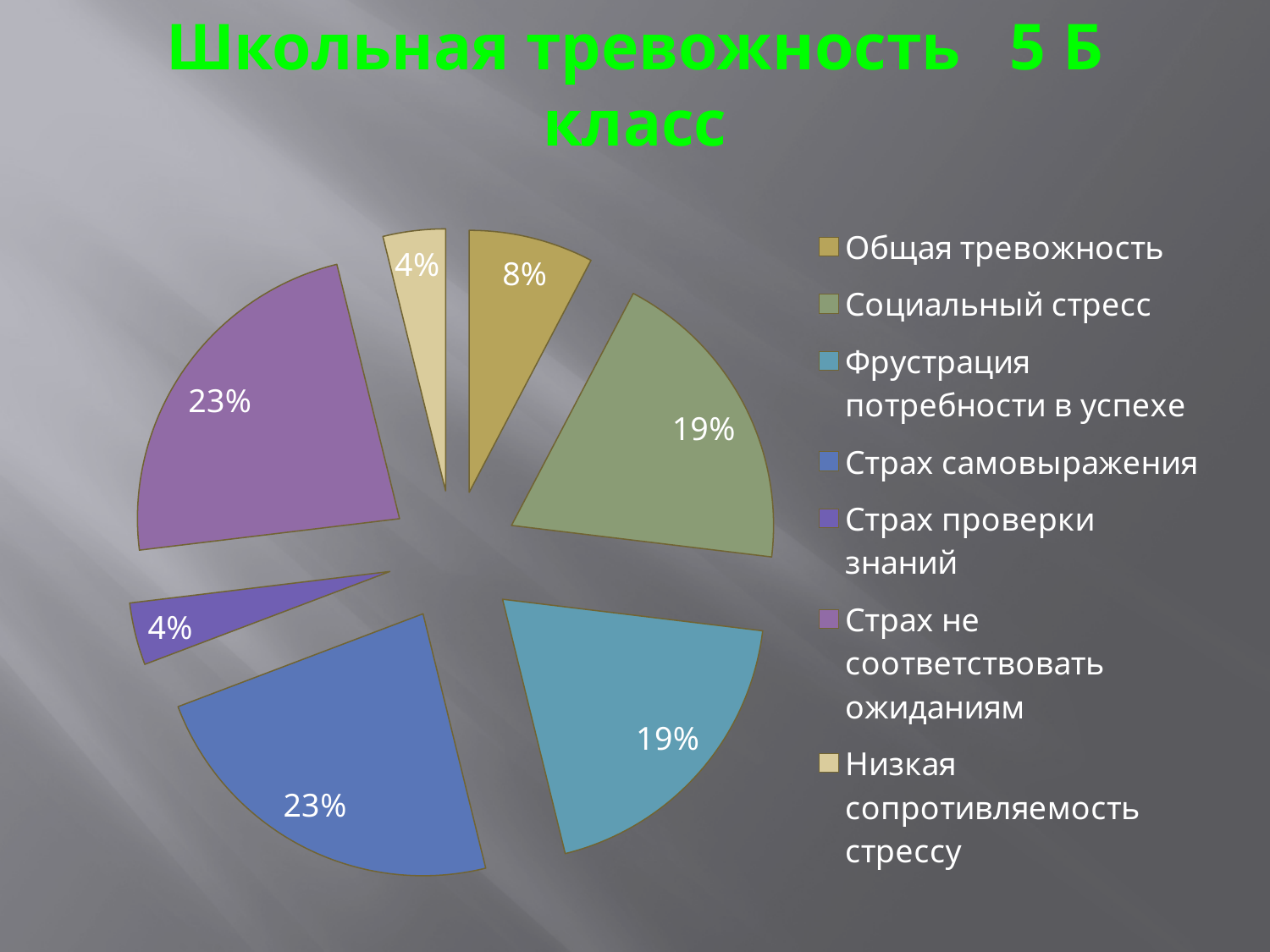
How many entries does the legend list? 7 How many slices does the pie chart have? 7 Which is larger, Общая тревожность or Социальный стресс? Социальный стресс What is the share for Страх самовыражения? 23% What is the share for Низкая сопротивляемость стрессу? 4% What is the difference between the shares for Страх самовыражения and Общая тревожность? 15% What is the share for Фрустрация потребности в успехе? 19% What is the share for Социальный стресс? 19% What is the title of the chart on the slide? Школьная тревожность 5 Б класс What type of chart is shown on the slide? pie chart What is the share for Общая тревожность? 8% What is the share for Страх проверки знаний? 4%